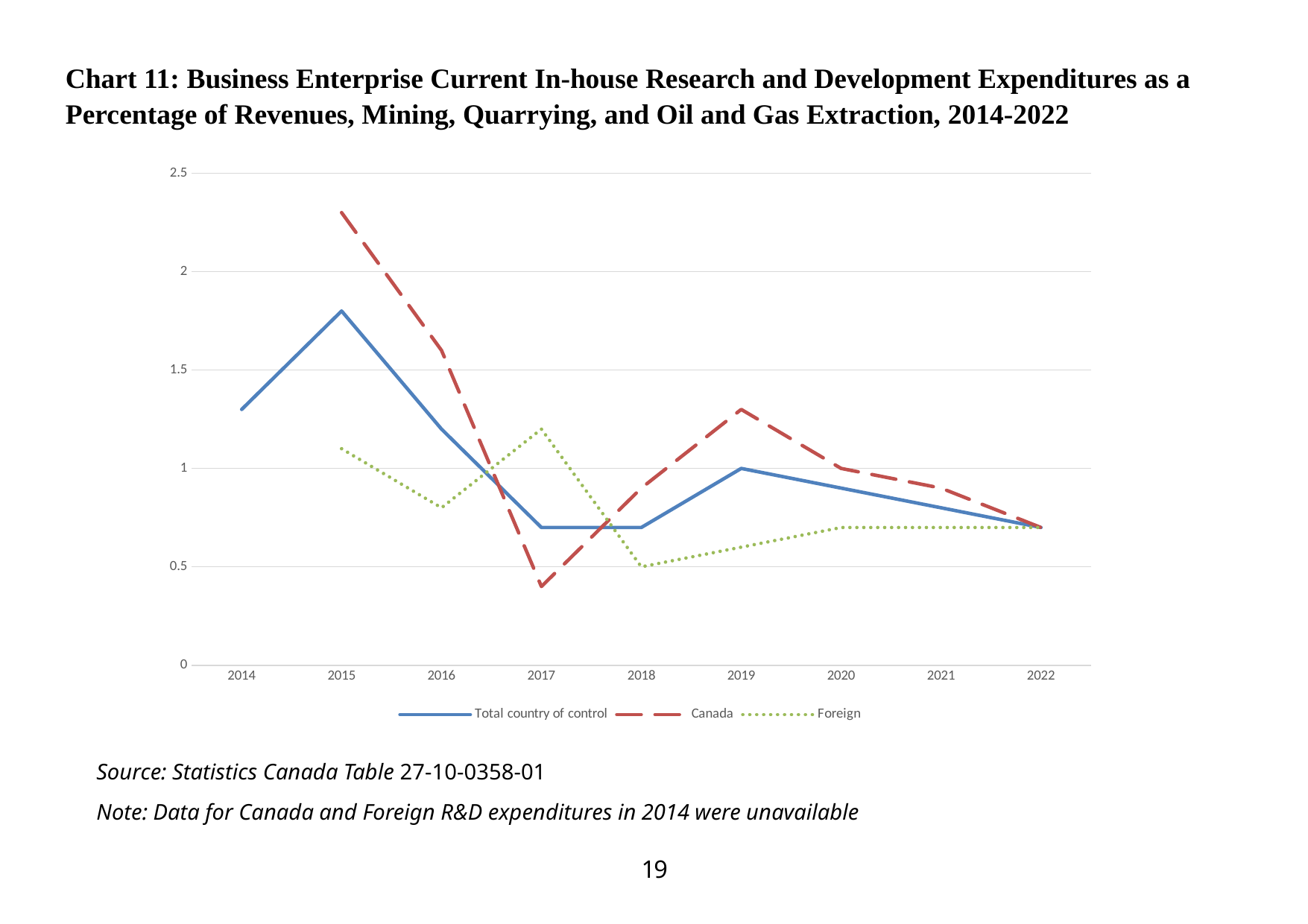
In 2015, which series has the larger value: Canada or Total country of control? Canada Is the value for Canada in 2017 greater or less than 0.5? less Is the value for Canada in 2015 greater or less than 2? greater In 2017, which series has the larger value: Foreign or Canada? Foreign How many years are shown on the x axis? 9 Does the Total country of control series rise or fall from 2019 to 2022? fall Is the value for Total country of control in 2015 greater or less than 1.5? greater What kind of chart is shown on the slide? line chart In which year does the Foreign series reach its lowest value? 2018 In which year does the Canada series reach its lowest value? 2017 How many series does the legend list? 3 In which year does the Canada series reach its highest value? 2015